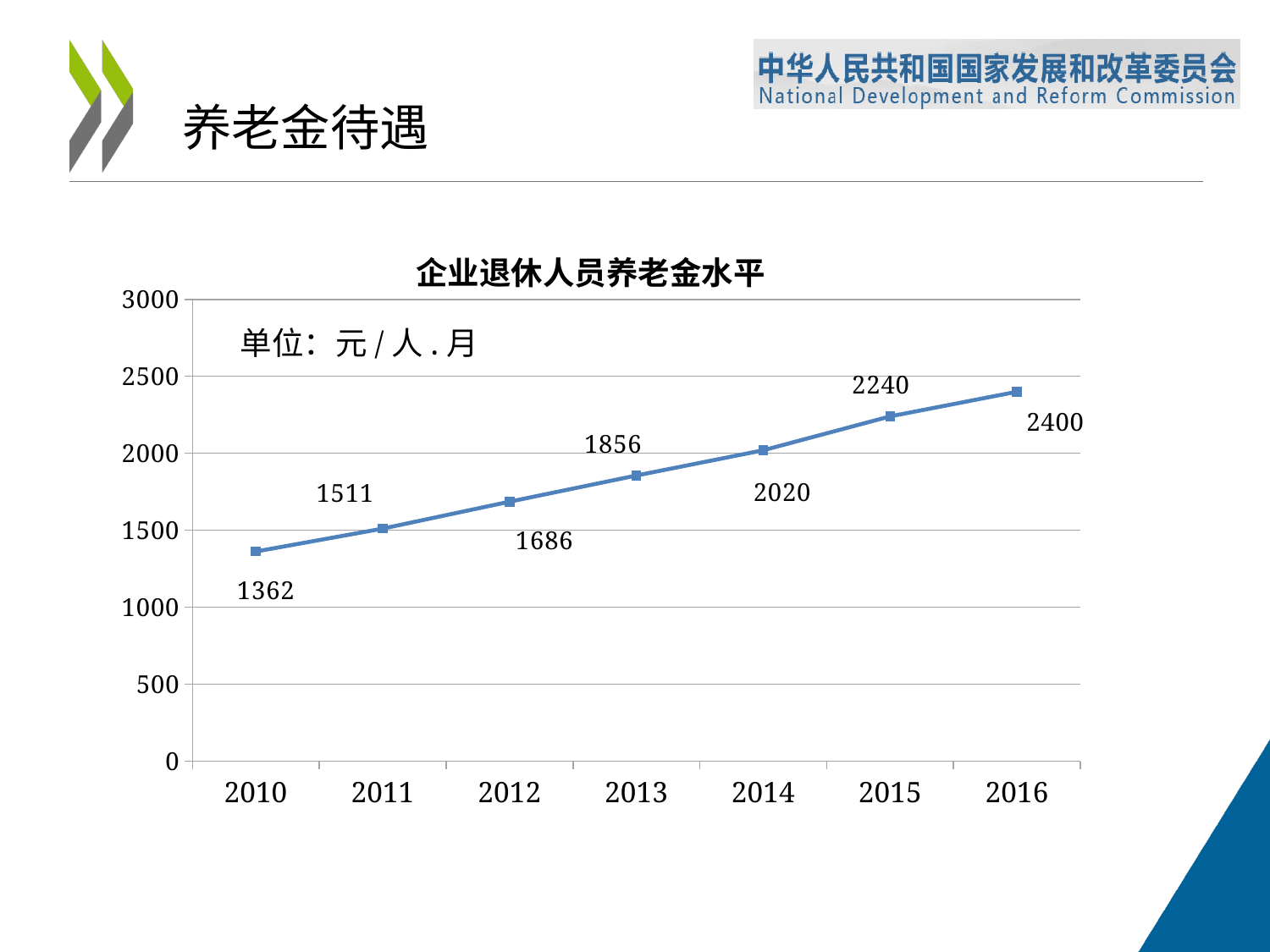
What kind of chart is shown? line chart Which year has the highest value? 2016 How many years are plotted on the chart? 7 What is the difference between the values for 2015 and 2014? 220 Is the value for 2014 greater or less than 2000? greater What is the value for 2013? 1856 Do the values rise or fall from 2010 to 2016? rise Which is larger, the value for 2012 or the value for 2014? 2014 What is the difference between the values for 2016 and 2010? 1038 What is the value for 2010? 1362 Which year has the lowest value? 2010 What is the value for 2016? 2400